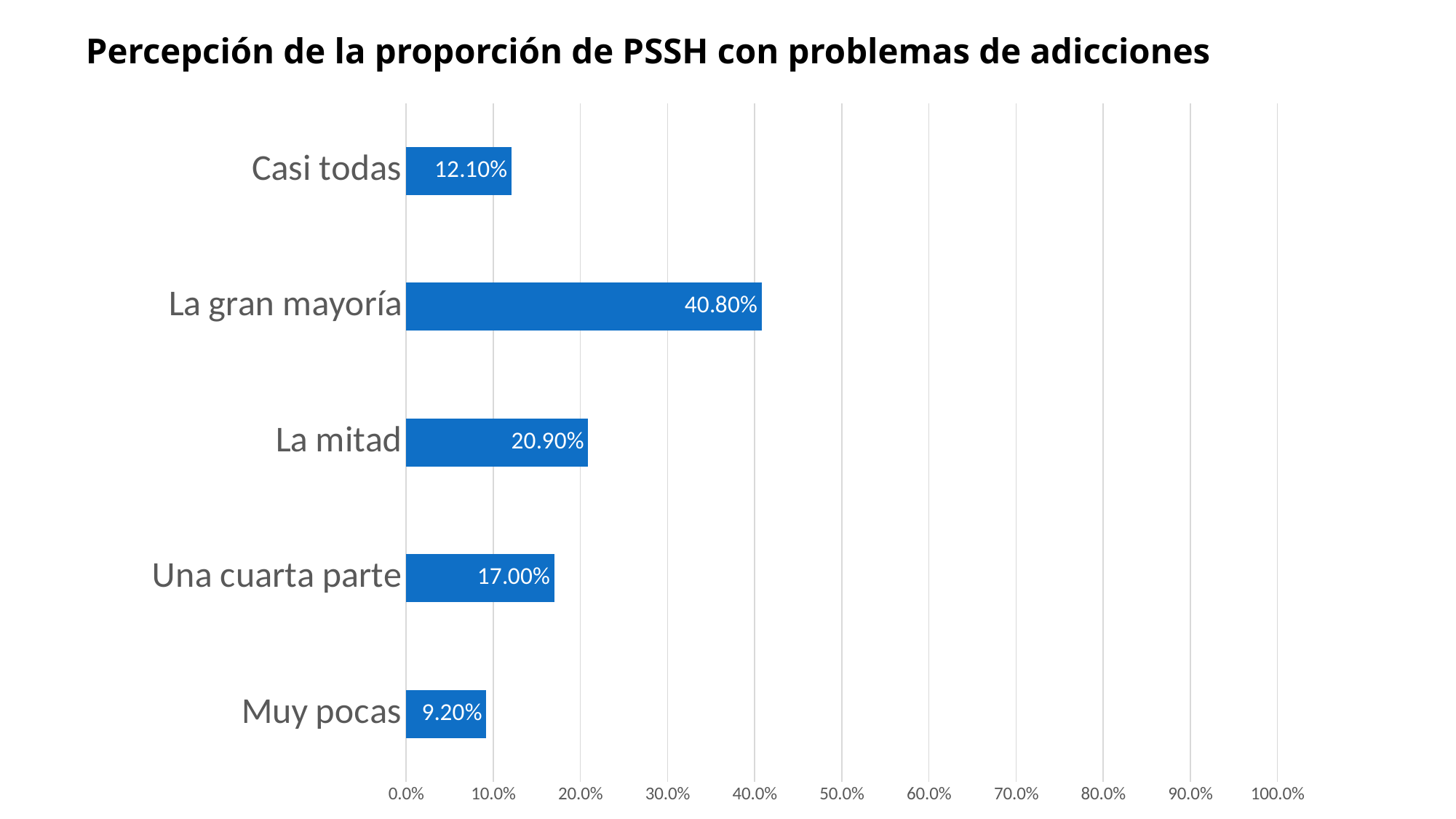
How many categories are shown in the chart? 5 What is the value for "La gran mayoría"? 40.80% Which is larger, the value for "La mitad" or the value for "Una cuarta parte"? La mitad What is the title of the chart? Percepción de la proporción de PSSH con problemas de adicciones What is the value for "Una cuarta parte"? 17.00% Which category has the lowest value? Muy pocas Which category has the highest value? La gran mayoría Is the value for "La gran mayoría" greater or less than 50.0%? less What kind of chart is shown on the slide? Bar chart What is the difference between the values for "La gran mayoría" and "La mitad"? 19.90% What is the value for "Muy pocas"? 9.20% What is the difference between the values for "Casi todas" and "Muy pocas"? 2.90%